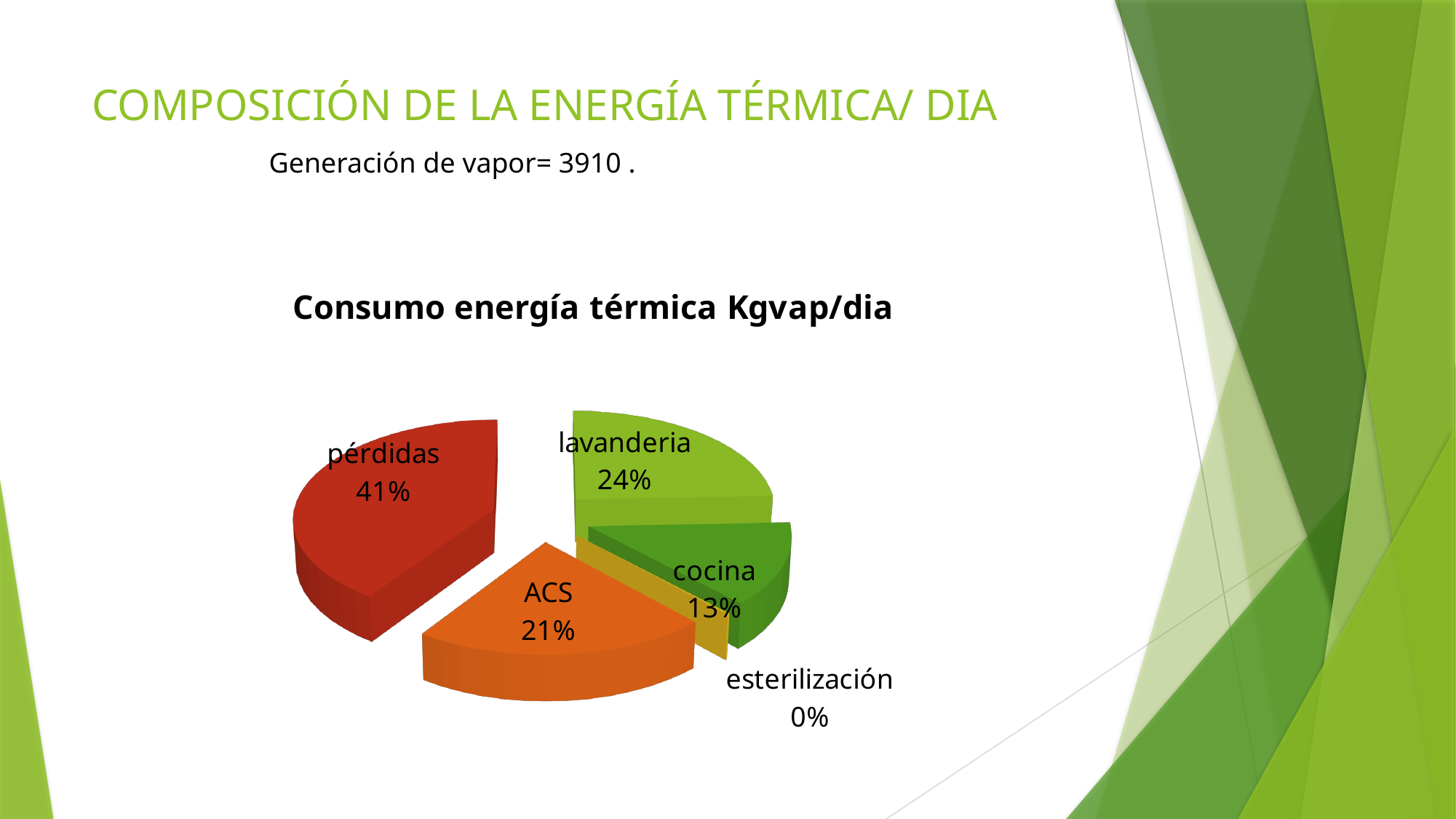
Which is larger, the share for ACS or the share for cocina? ACS What share of the pie does esterilización represent? 0% What share of the pie does ACS represent? 21% What kind of chart is shown on the slide? pie chart What share of the pie does pérdidas represent? 41% Which category has the smallest share of the pie? esterilización Which category has the largest share of the pie? pérdidas How many categories are shown in the pie chart? 5 What is the difference in percentage points between pérdidas and lavanderia? 17% What is the title of the chart? Consumo energía térmica Kgvap/dia